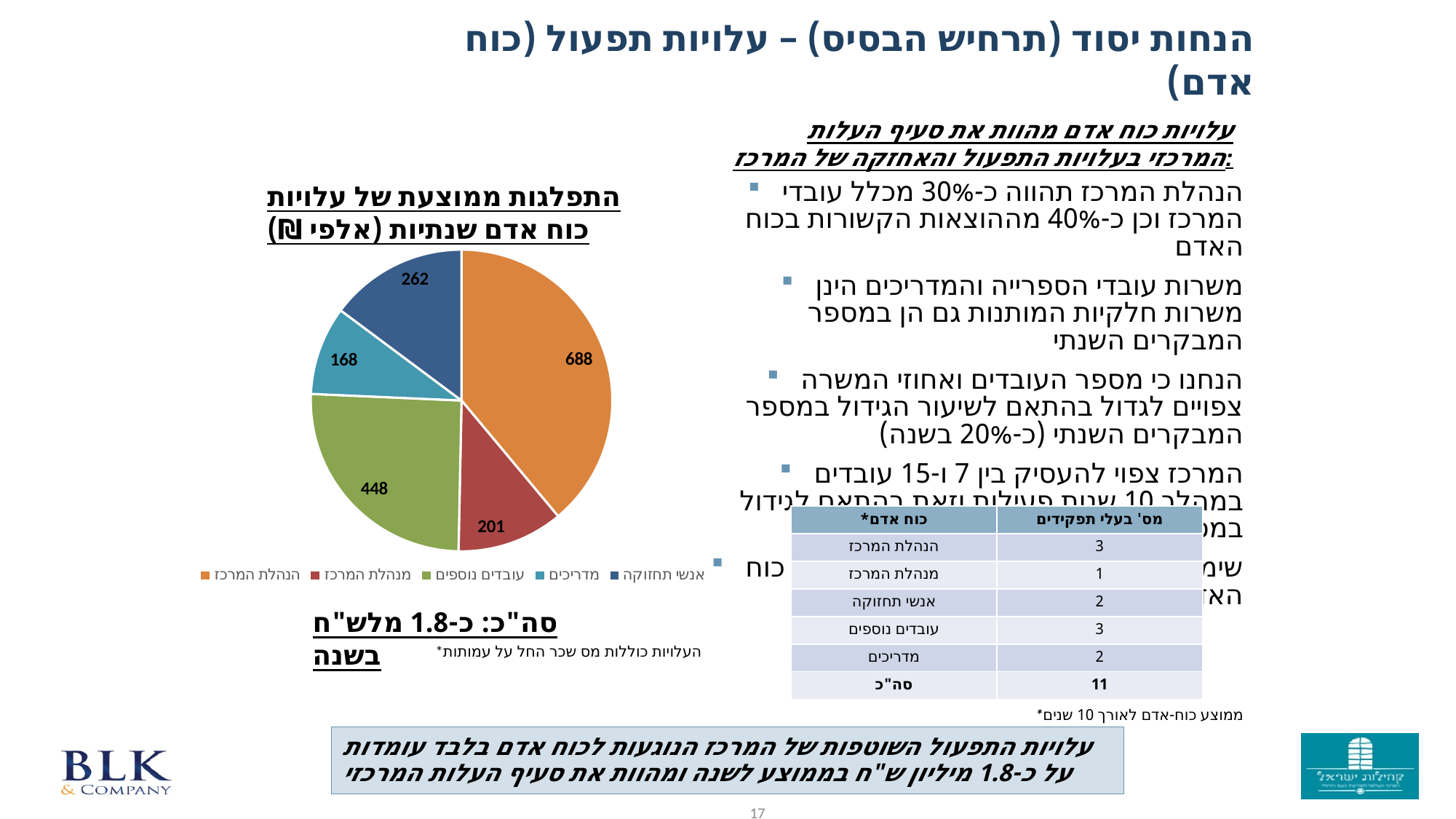
What is the total of all the slices in the pie chart? 1767 Which category has the largest slice in the pie chart? הנהלת המרכז What colour is the slice for עובדים נוספים in the pie chart? green How many categories are shown in the pie chart? 5 Which is larger: the value for אנשי תחזוקה or the value for מנהלת המרכז? אנשי תחזוקה What is the value for מדריכים in the pie chart? 168 What is the value for אנשי תחזוקה in the pie chart? 262 What is the value for מנהלת המרכז in the pie chart? 201 What is the value for הנהלת המרכז in the pie chart? 688 Which category has the smallest slice in the pie chart? מדריכים What is the difference between the values for הנהלת המרכז and עובדים נוספים? 240 What type of chart is shown on the slide? pie chart